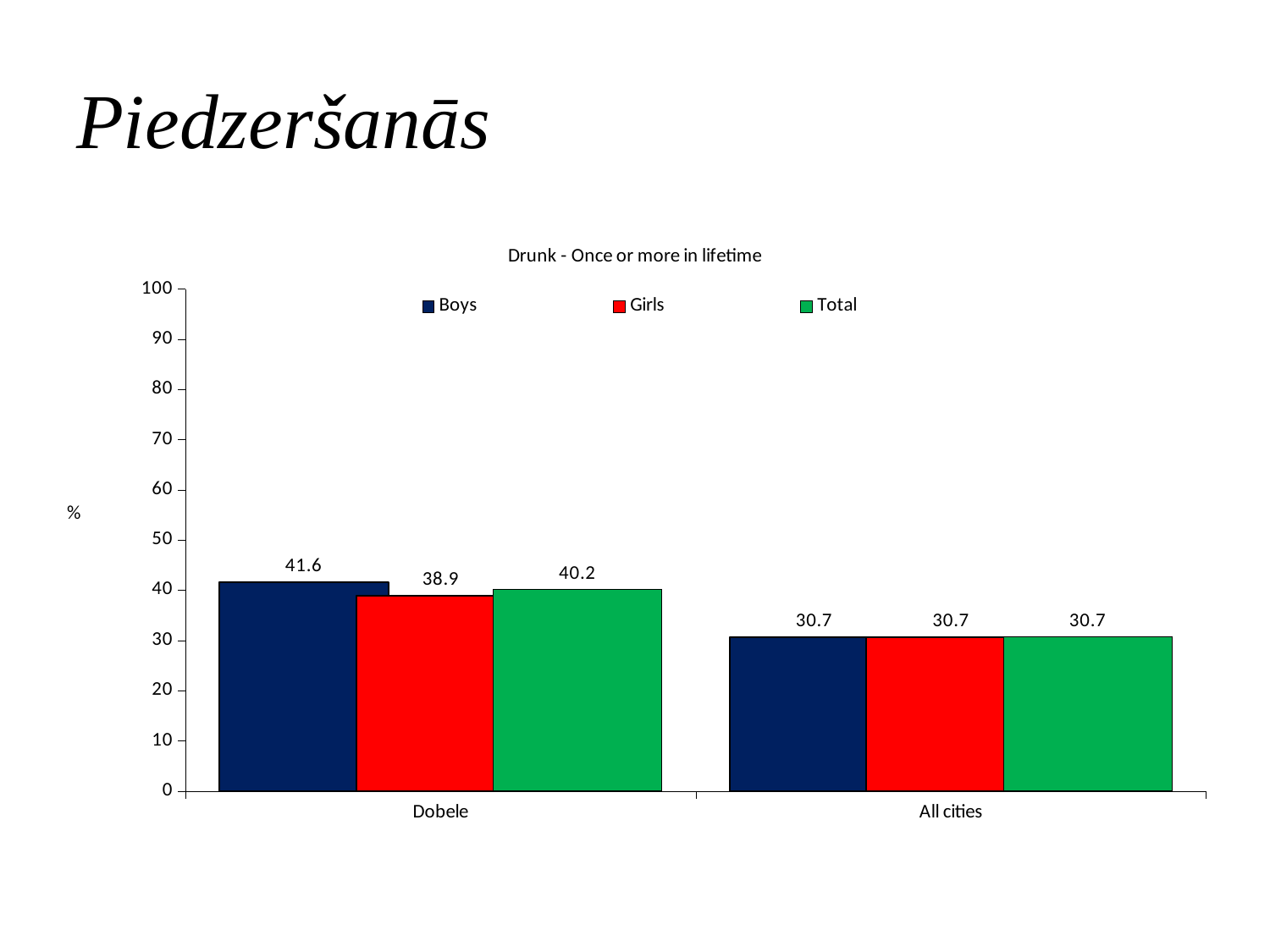
How many series does the legend list? 3 What is the value for Boys in Dobele? 41.6 What is the value for Girls in Dobele? 38.9 Which series has the lowest value in Dobele? Girls Which series has the highest value in Dobele? Boys How many categories are shown on the x axis? 2 What is the difference between the Boys value in Dobele and the Boys value in All cities? 10.9 What kind of chart is shown? bar chart Which is larger, the Total value for Dobele or the Total value for All cities? Dobele Is the value for Girls in Dobele greater or less than 30? greater What is the value for Total in All cities? 30.7 What is the title of the chart? Drunk - Once or more in lifetime